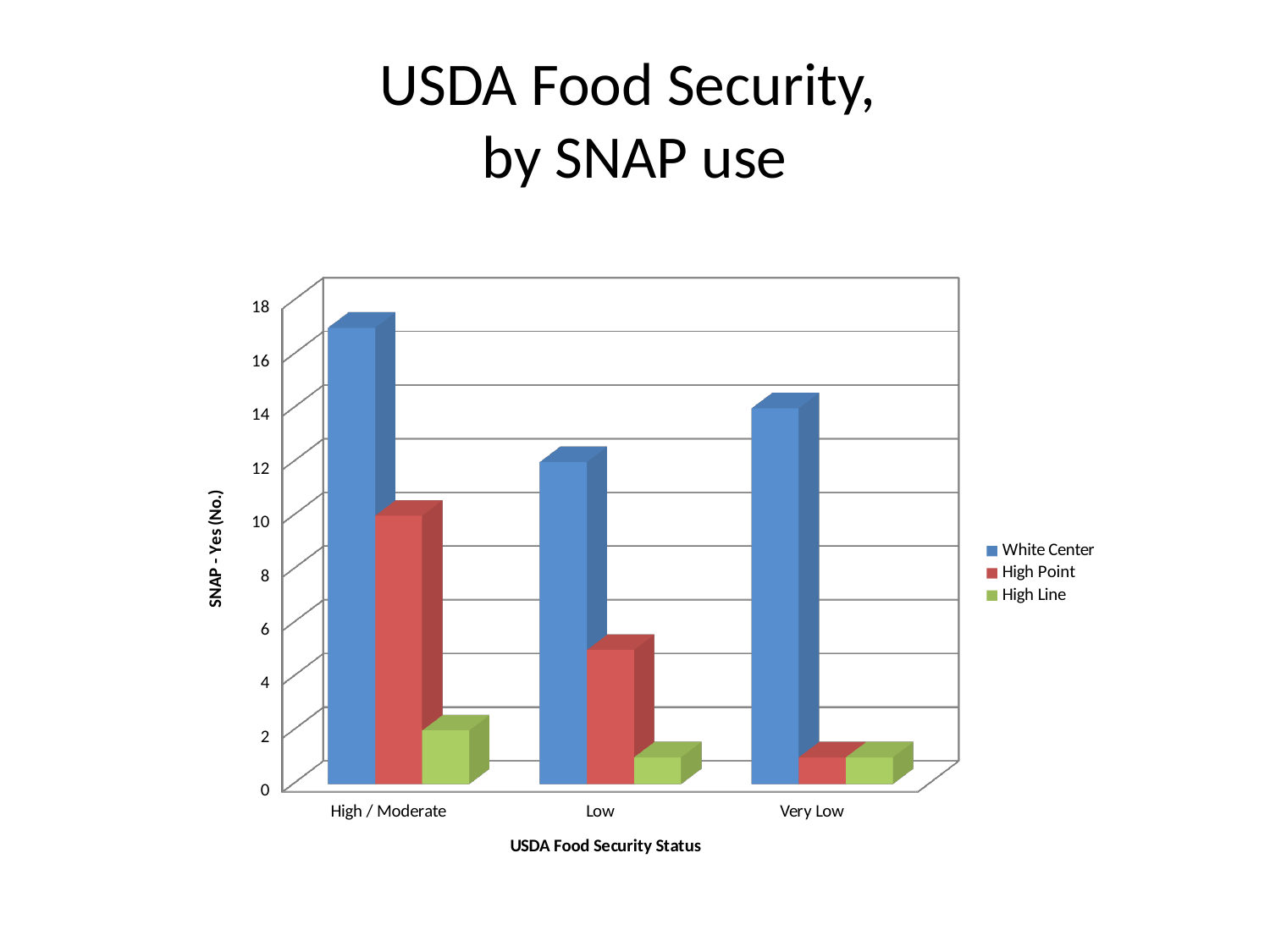
Is the High Point value for High / Moderate greater or less than 8? greater For which food security status is the White Center value highest? High / Moderate Do the High Point values rise or fall moving from High / Moderate to Very Low along the x axis? fall For which food security status is the High Point value lowest? Very Low What is the title of the vertical axis? SNAP - Yes (No.) What kind of chart is shown on the slide? bar chart Is the White Center value for High / Moderate greater or less than 16? greater In the High / Moderate category, which is larger: High Point or High Line? High Point How many food security status categories are shown on the x axis? 3 Is the High Line value for High / Moderate greater or less than 4? less How many series does the legend list? 3